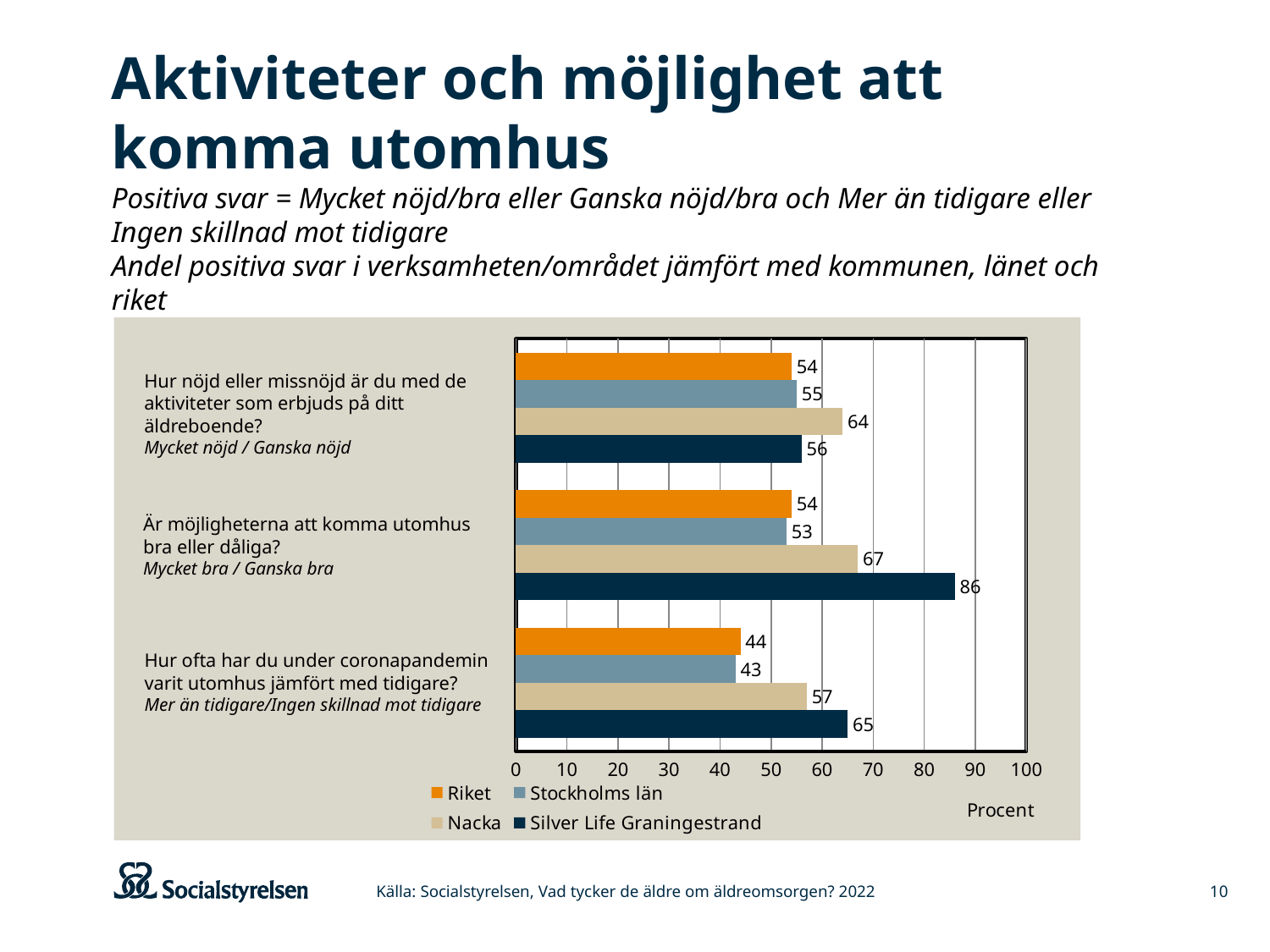
What is the value for Riket on the question "Hur ofta har du under coronapandemin varit utomhus jämfört med tidigare?"? 44 What is the difference between Nacka and Riket on the question "Hur nöjd eller missnöjd är du med de aktiviteter som erbjuds på ditt äldreboende?"? 10 What is the difference between Silver Life Graningestrand and Nacka on the question "Är möjligheterna att komma utomhus bra eller dåliga?"? 19 Which is larger on the question "Hur ofta har du under coronapandemin varit utomhus jämfört med tidigare?": Silver Life Graningestrand or Nacka? Silver Life Graningestrand What kind of chart is shown on the slide? Bar chart What is the value for Silver Life Graningestrand on the question "Är möjligheterna att komma utomhus bra eller dåliga?"? 86 How many question categories are shown on the chart? 3 How many series does the legend list? 4 What is the value for Nacka on the question "Hur nöjd eller missnöjd är du med de aktiviteter som erbjuds på ditt äldreboende?"? 64 What is the value for Stockholms län on the question "Hur ofta har du under coronapandemin varit utomhus jämfört med tidigare?"? 43 Which series has the highest value on the question "Är möjligheterna att komma utomhus bra eller dåliga?"? Silver Life Graningestrand Which series has the lowest value on the question "Hur ofta har du under coronapandemin varit utomhus jämfört med tidigare?"? Stockholms län